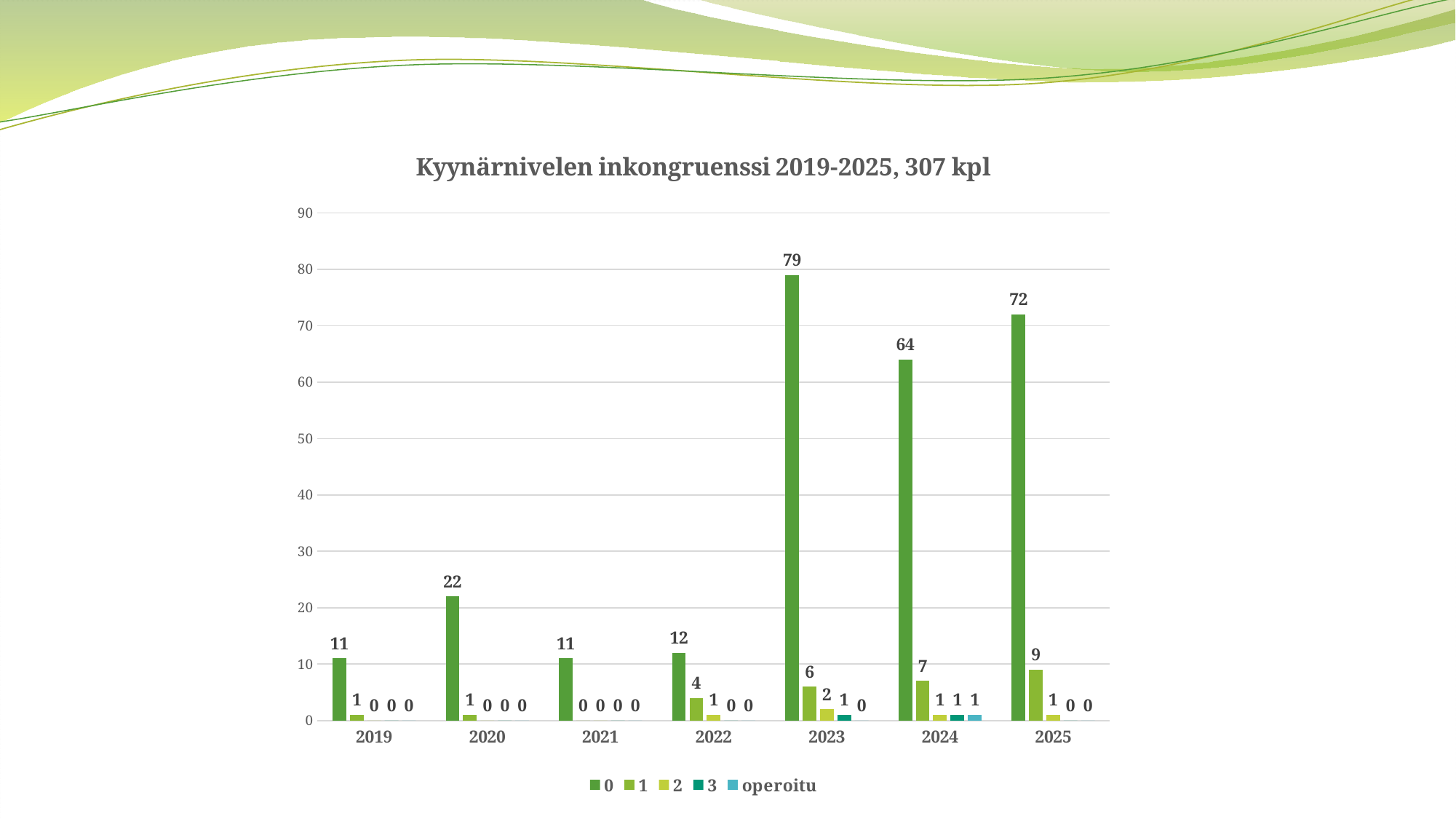
Which is larger, the series 0 value for 2020 or for 2022? 2020 Which year has the highest value for series 0? 2023 What is the value for series 2 in 2023? 2 Is the value for series 0 in 2025 greater or less than 70? greater How many years are shown on the x axis? 7 What is the title of the chart? Kyynärnivelen inkongruenssi 2019-2025, 307 kpl What is the value for series 1 in 2025? 9 How many series does the legend list? 5 What is the difference between the series 0 values for 2023 and 2024? 15 Which year has the lowest value for series 1? 2021 What kind of chart is shown on the slide? bar chart What is the value for series 0 in 2023? 79